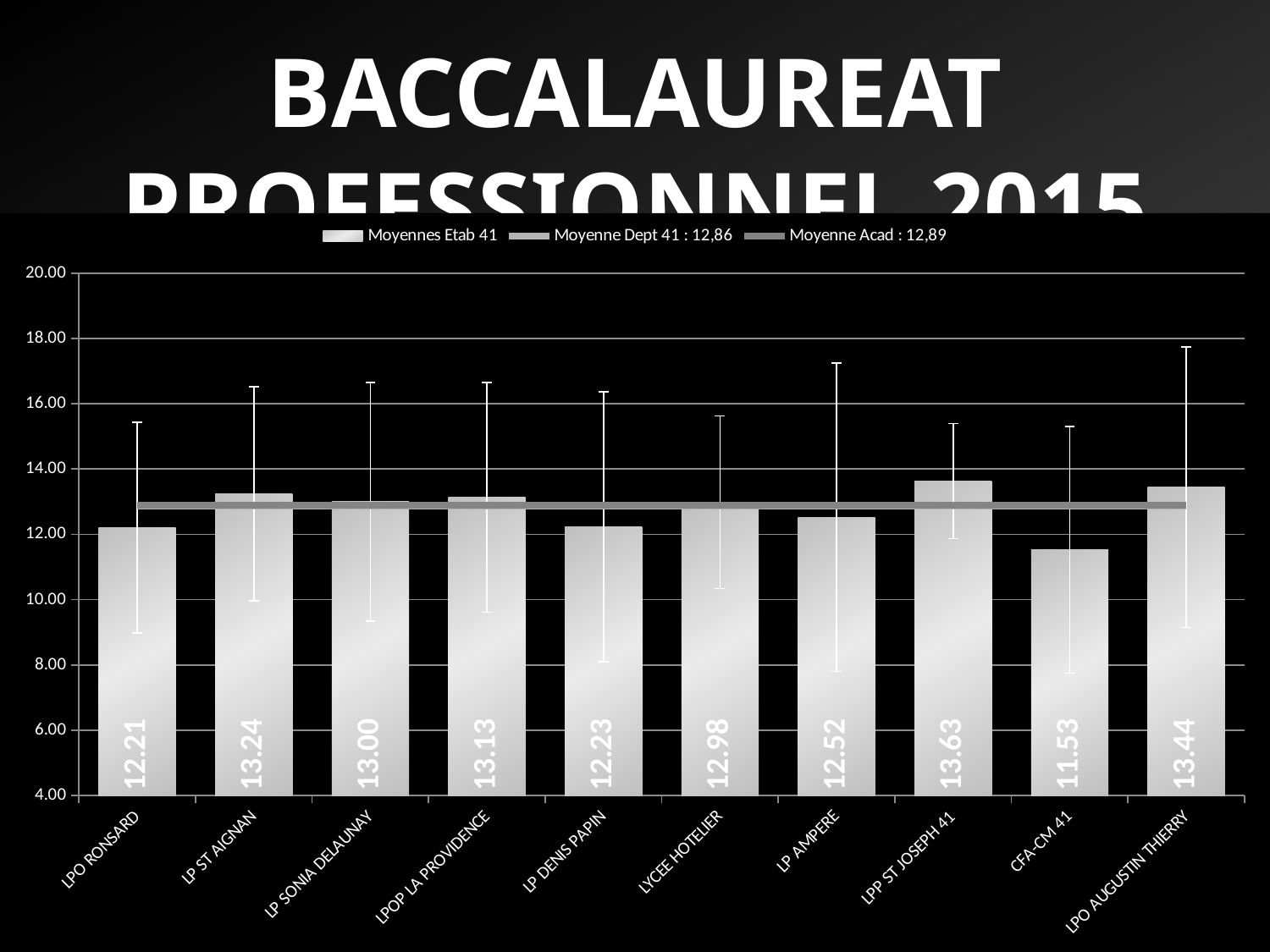
Is the value for LYCEE HOTELIER greater or less than 14.00? less According to the legend, what is the value of Moyenne Dept 41? 12,86 What kind of chart is shown on the slide? combination bar and line chart What is the value for CFA-CM 41? 11.53 Which establishment has the lowest value? CFA-CM 41 What is the value for LPO RONSARD? 12.21 What is the difference between the values for LPO AUGUSTIN THIERRY and LP DENIS PAPIN? 1.21 What is the value for LPP ST JOSEPH 41? 13.63 How many series does the legend list? 3 How many establishments are shown on the x axis? 10 Which is larger, the value for LP ST AIGNAN or the value for LP AMPERE? LP ST AIGNAN Which establishment has the highest value? LPP ST JOSEPH 41